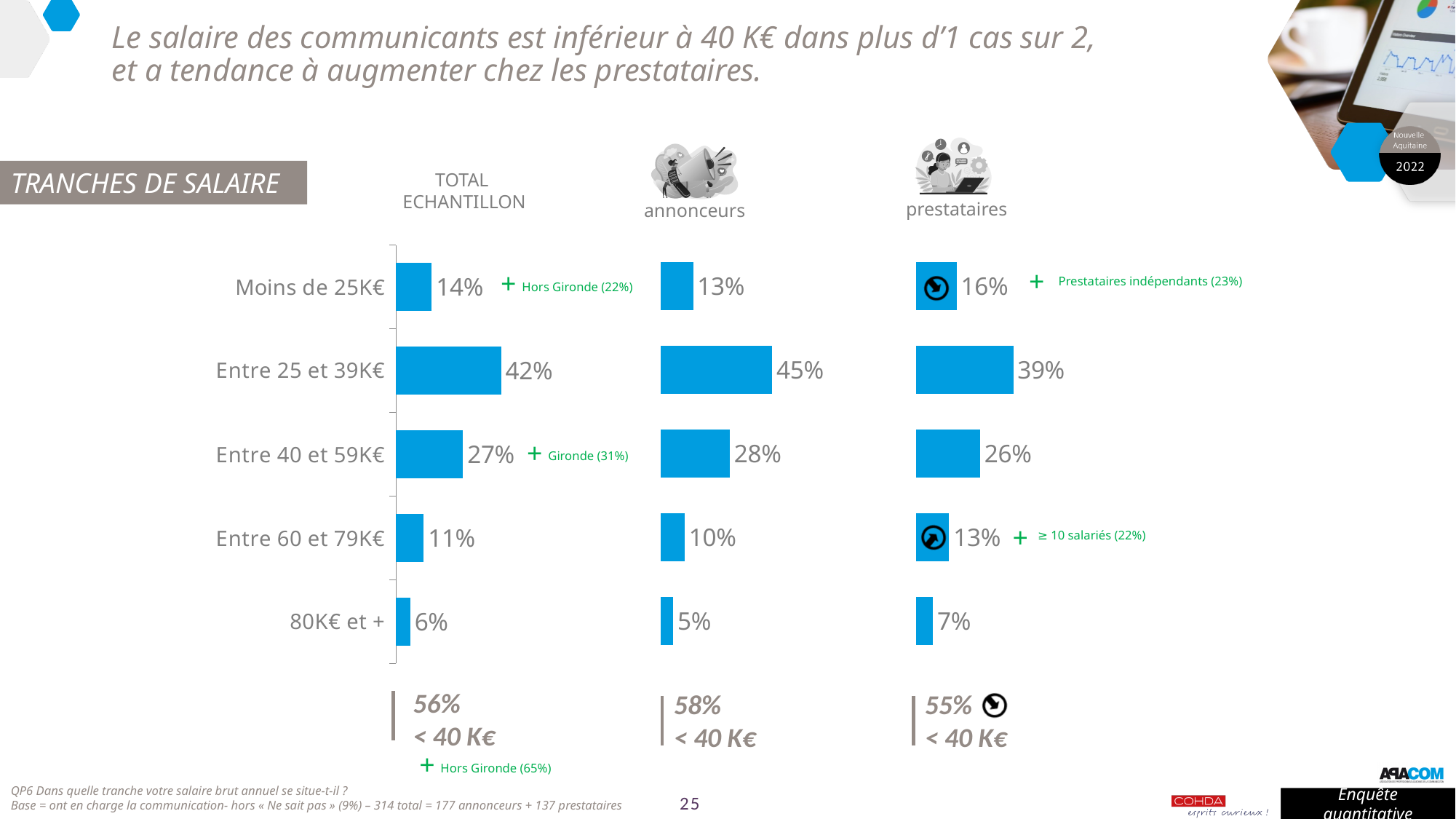
In the prestataires chart, what is the value for 'Moins de 25K€'? 16% In the prestataires chart, which salary bracket has the lowest value? 80K€ et + In the annonceurs chart, which salary bracket has the highest value? Entre 25 et 39K€ In the annonceurs chart, what is the value for '80K€ et +'? 5% How many salary brackets are shown in the TOTAL ECHANTILLON chart? 5 In the annonceurs chart, what is the value for 'Entre 40 et 59K€'? 28% In the TOTAL ECHANTILLON chart, what percentage of respondents earn 'Entre 25 et 39K€'? 42% What is the difference between the annonceurs and prestataires values for 'Entre 25 et 39K€'? 6 percentage points For 'Entre 60 et 79K€', which group has the larger value, annonceurs or prestataires? prestataires In the TOTAL ECHANTILLON chart, what is the combined share of respondents earning less than 40K€ as printed on the slide? 56% What is the difference between the TOTAL ECHANTILLON values for 'Entre 40 et 59K€' and 'Entre 60 et 79K€'? 16 percentage points What type of chart is used to show the salary brackets on this slide? Bar chart